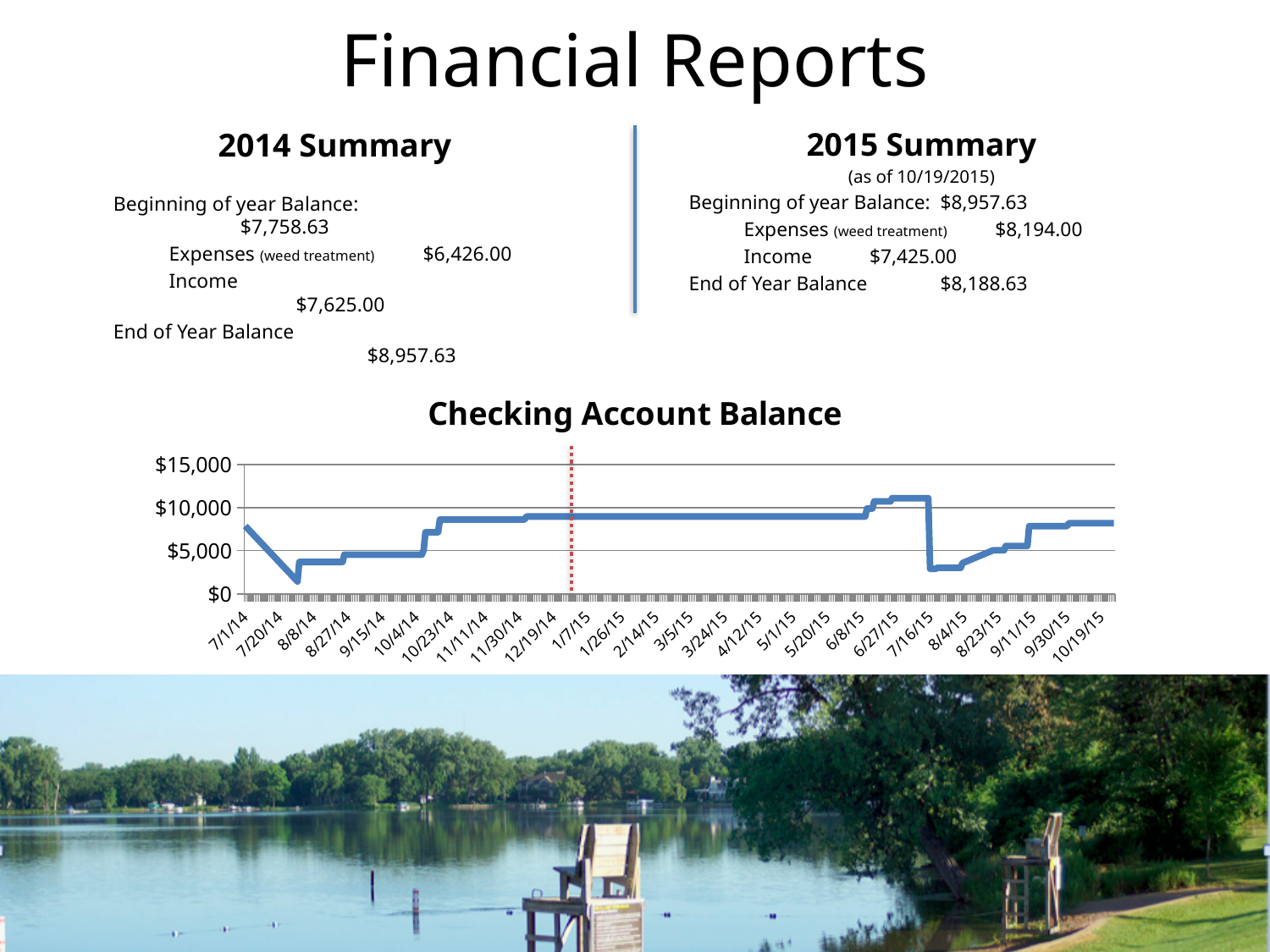
What kind of chart is the Checking Account Balance chart? line chart In the Checking Account Balance chart, does the balance rise or fall between 8/8/14 and 12/19/14? rise What is the title of the chart on the slide? Checking Account Balance In the Checking Account Balance chart, does the balance rise or fall between 7/1/14 and 8/8/14? fall In the Checking Account Balance chart, is the balance at 8/8/14 greater or less than $5,000? less In the Checking Account Balance chart, is the balance at 7/1/14 greater or less than $5,000? greater In the Checking Account Balance chart, is the balance at 1/7/15 greater or less than $5,000? greater What is the highest value shown on the y axis of the Checking Account Balance chart? $15,000